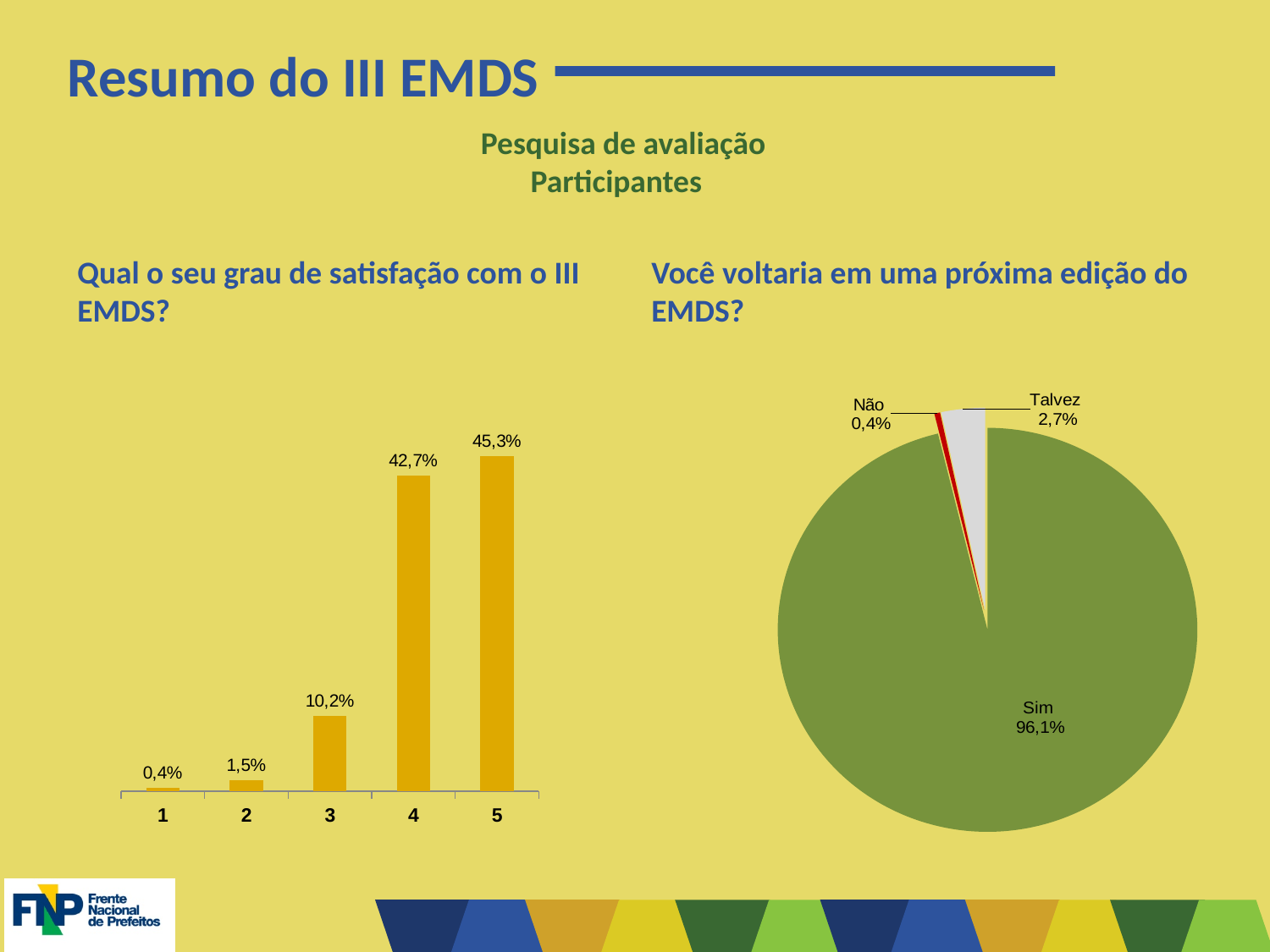
In the bar chart on the left (satisfaction with III EMDS), what is the value for category 3? 10,2% In the pie chart on the right (would you return to a next edition of EMDS), which slice is the smallest? Não In the bar chart on the left (satisfaction with III EMDS), which category has the highest value? 5 In the bar chart on the left (satisfaction with III EMDS), how many categories are shown? 5 In the bar chart on the left (satisfaction with III EMDS), do the values rise or fall from category 1 to category 5? rise In the bar chart on the left (satisfaction with III EMDS), what is the value for category 4? 42,7% In the bar chart on the left (satisfaction with III EMDS), what is the difference between the values for categories 5 and 4? 2,6% In the bar chart on the left (satisfaction with III EMDS), which is larger, the value for category 2 or category 3? 3 In the pie chart on the right (would you return to a next edition of EMDS), what share does 'Sim' have? 96,1% In the bar chart on the left (satisfaction with III EMDS), which category has the lowest value? 1 In the pie chart on the right (would you return to a next edition of EMDS), what is the value for 'Talvez'? 2,7% What kind of chart is the chart on the left (satisfaction with III EMDS)? bar chart